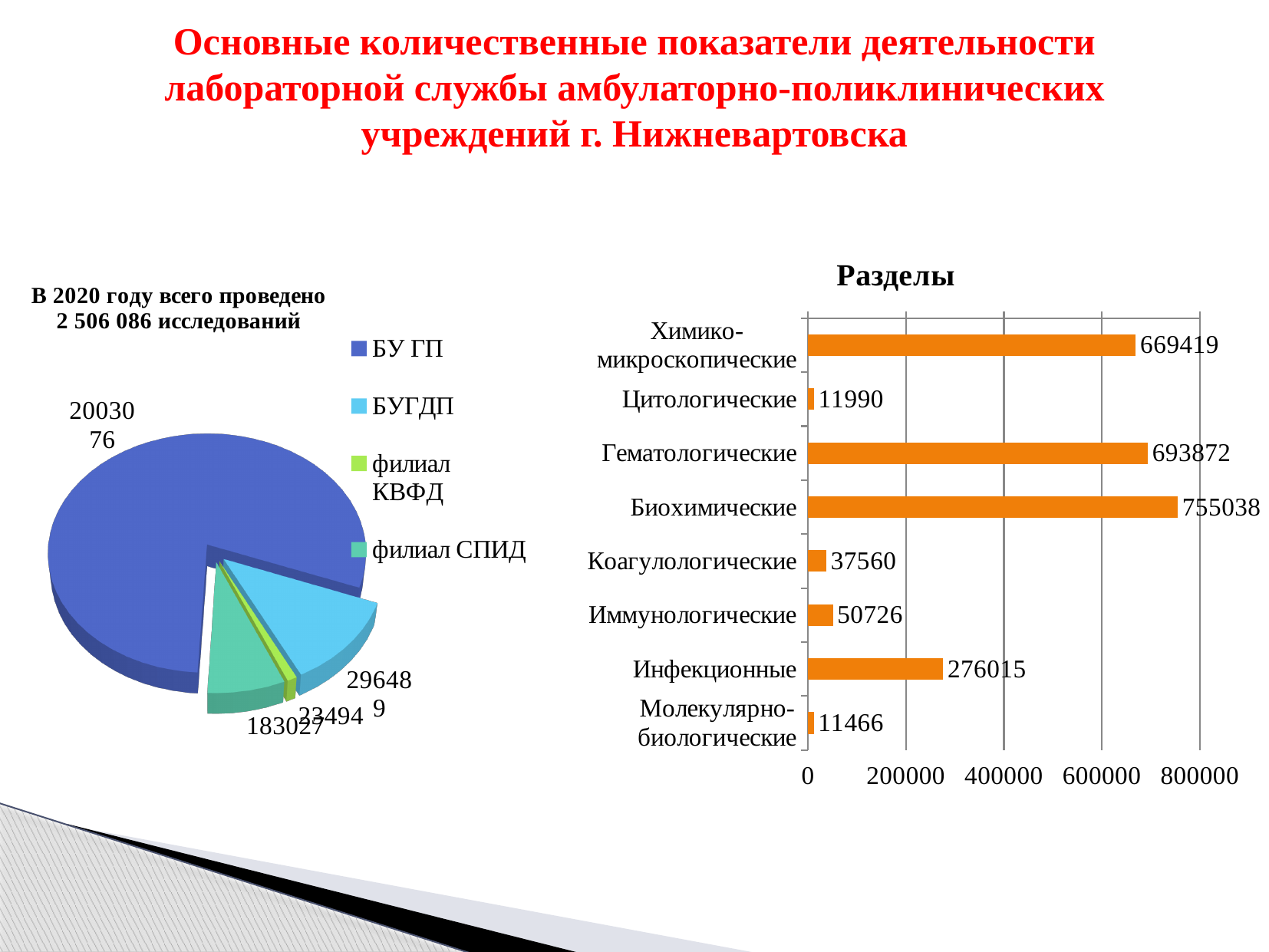
On the chart titled "Разделы", which is larger: Иммунологические or Инфекционные? Инфекционные On the chart titled "Разделы", is the value for Химико-микроскопические greater or less than 600000? greater On the chart titled "Разделы", which category has the highest value? Биохимические What kind of chart is the chart on the left of the slide? pie chart On the chart titled "Разделы", which category has the lowest value? Молекулярно-биологические On the chart titled "Разделы", what is the value for Биохимические? 755038 On the chart titled "Разделы", what is the difference between the values for Биохимические and Гематологические? 61166 How many categories are shown on the chart titled "Разделы"? 8 On the chart titled "Разделы", what is the value for Коагулологические? 37560 On the chart titled "Разделы", what is the value for Инфекционные? 276015 How many entries does the legend of the pie chart on the left list? 4 What kind of chart is the chart titled "Разделы"? bar chart